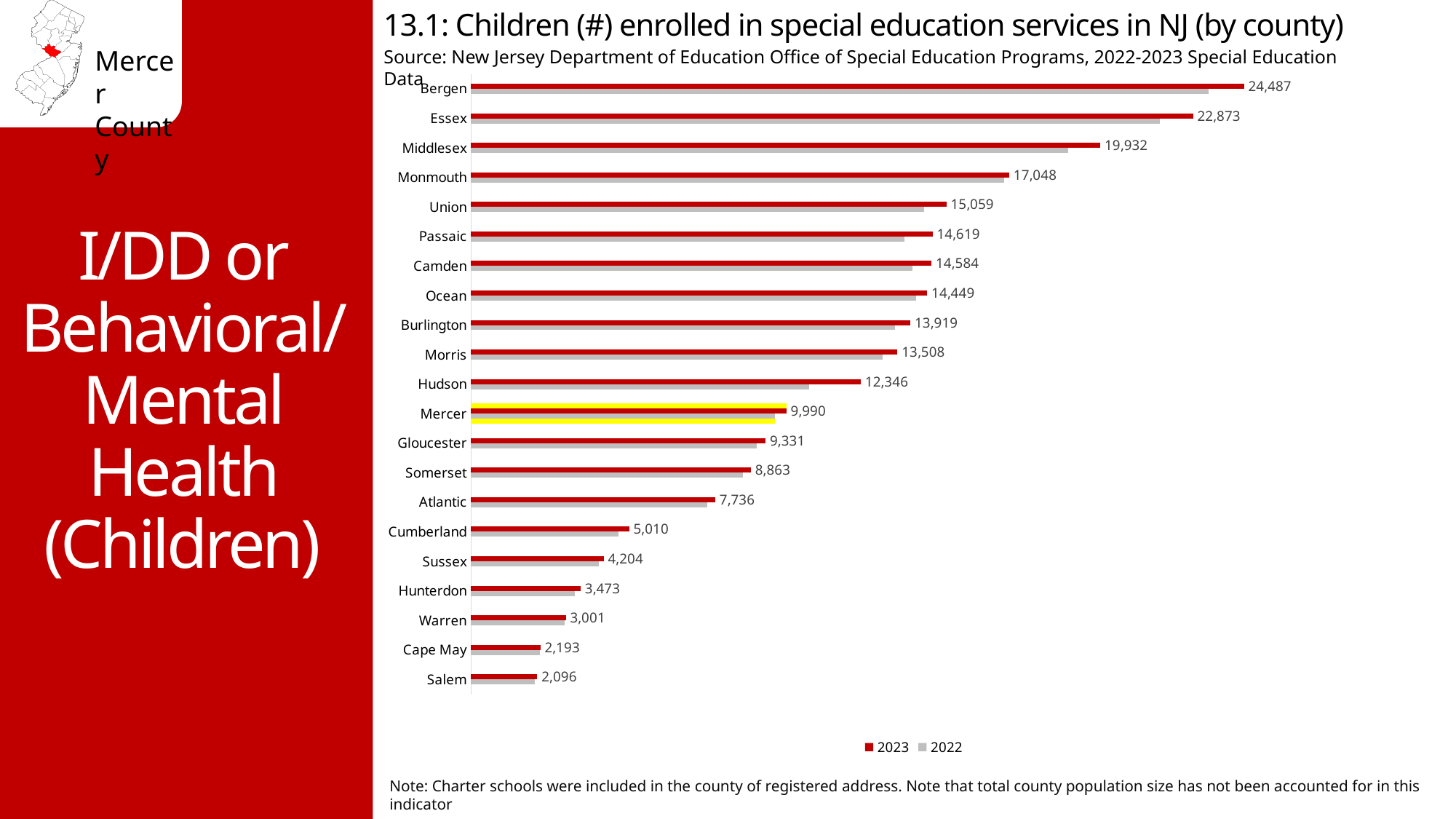
What is the 2023 value for Bergen? 24,487 What kind of chart is shown on the slide? bar chart What is the difference between the 2023 values for Bergen and Essex? 1,614 What is the difference between the 2023 values for Mercer and Gloucester? 659 Which county has the lowest 2023 value? Salem Which county's bars are highlighted in yellow? Mercer What is the 2023 value for Mercer? 9,990 Which county has the highest 2023 value? Bergen For Hudson, is the 2023 value or the 2022 value larger? 2023 How many counties are shown in the chart? 21 What is the 2023 value for Cumberland? 5,010 How many series does the legend list? 2